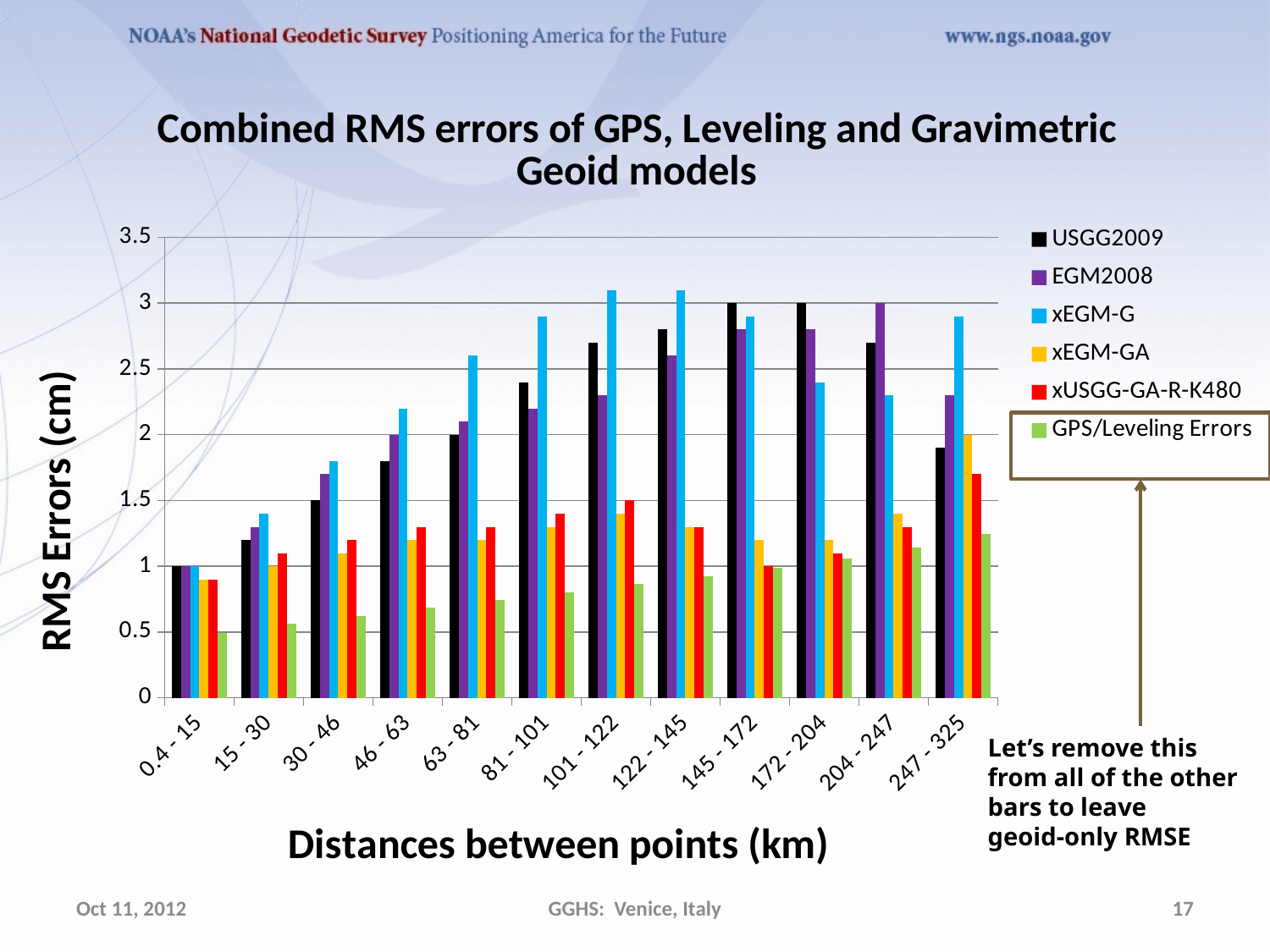
Which series has the lowest value at 0.4 - 15 km? GPS/Leveling Errors How many distance categories are shown on the x axis? 12 What kind of chart is shown on the slide? bar chart What is the title of the chart? Combined RMS errors of GPS, Leveling and Gravimetric Geoid models Do the GPS/Leveling Errors values rise or fall as the distance between points increases? rise Is the value for GPS/Leveling Errors at 63 - 81 km greater or less than 1? less Is the value for xEGM-G at 122 - 145 km greater or less than 3? greater What is the label of the y axis? RMS Errors (cm) Is the value for GPS/Leveling Errors at 247 - 325 km greater or less than 1? greater How many series does the legend list? 6